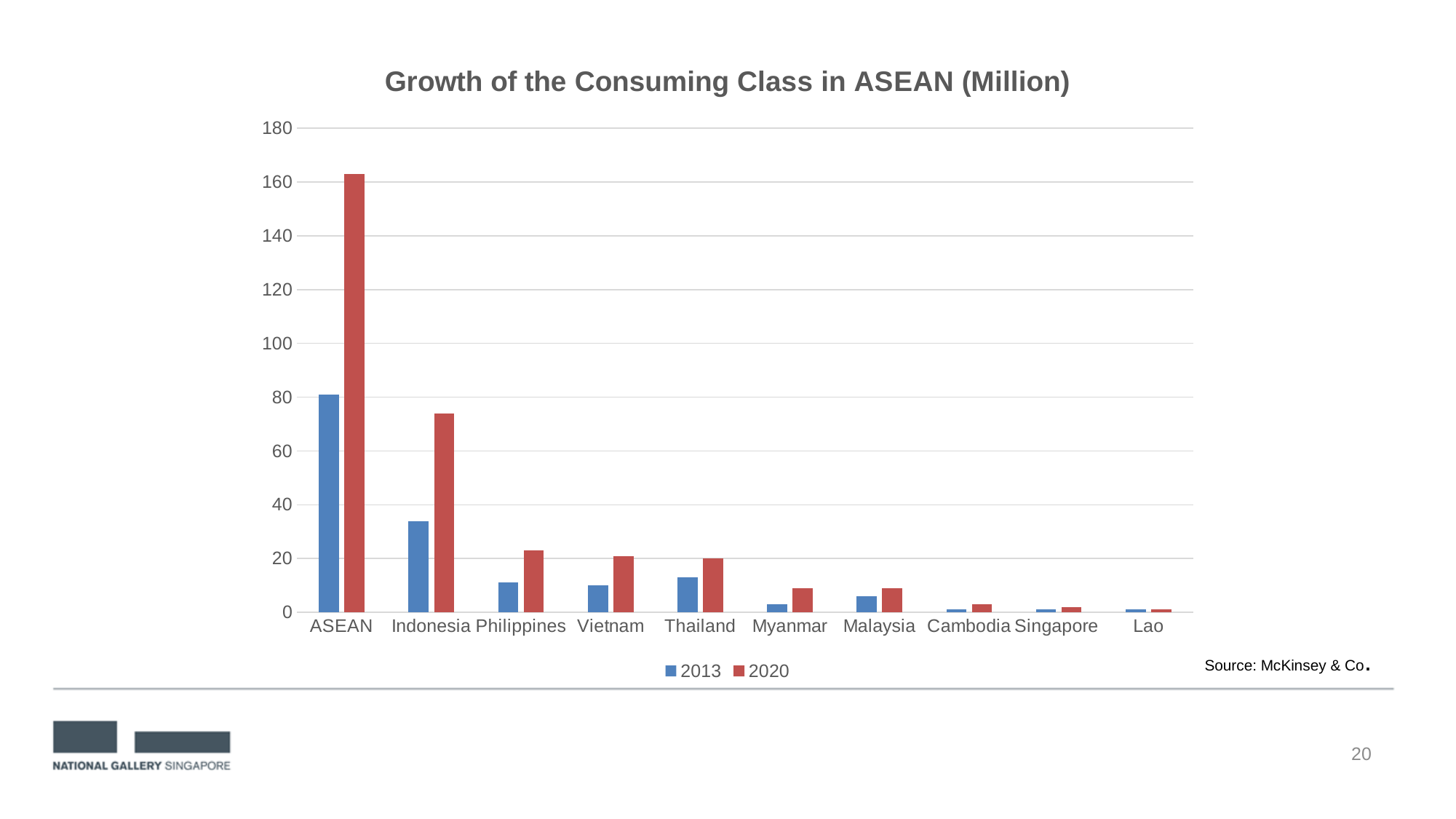
Is the 2020 value for ASEAN greater or less than 140? greater Is the 2013 value for Thailand greater or less than 20? less Is the 2020 value for Indonesia greater or less than 60? greater What kind of chart is shown on the slide? bar chart Which category has the highest 2020 value? ASEAN How many categories are shown on the x axis? 10 Which is larger, the 2020 value for Indonesia or the 2020 value for the Philippines? Indonesia Among the individual countries (excluding ASEAN), which has the highest 2020 value? Indonesia What is the title of the chart? Growth of the Consuming Class in ASEAN (Million) How many series does the legend list? 2 For each category, is the 2020 bar higher or lower than the 2013 bar? Higher for every category except Lao, where the 2013 and 2020 bars are equal